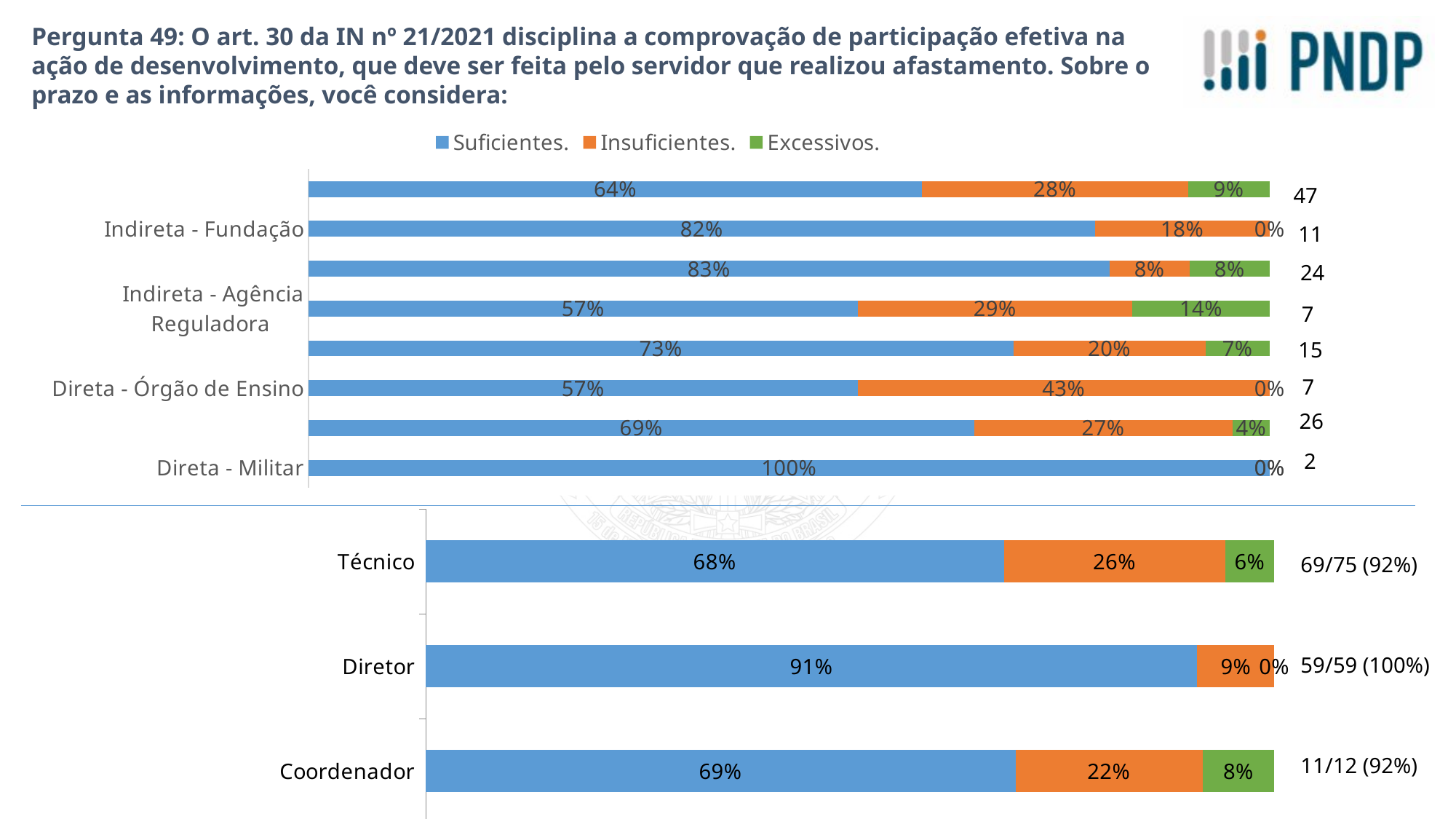
In the bottom chart, what is the Insuficientes value for Técnico? 26% In the top chart, what is the Insuficientes value for Direta - Órgão de Ensino? 43% In the bottom chart, which category has the highest Suficientes value? Diretor In the bottom chart, how much higher is the Suficientes value for Diretor than for Técnico? 23 percentage points What type of chart is the bottom chart? Stacked bar chart In the top chart, what is the Excessivos value for Indireta - Agência Reguladora? 14% How many series does the legend of the top chart list? 3 How many categories are shown in the bottom chart? 3 In the bottom chart, what is the Suficientes value for Diretor? 91% In the bottom chart, what is the Excessivos value for Coordenador? 8% In the top chart, what is the Suficientes value for Indireta - Fundação? 82% In the top chart, what is the Suficientes value for Direta - Militar? 100%